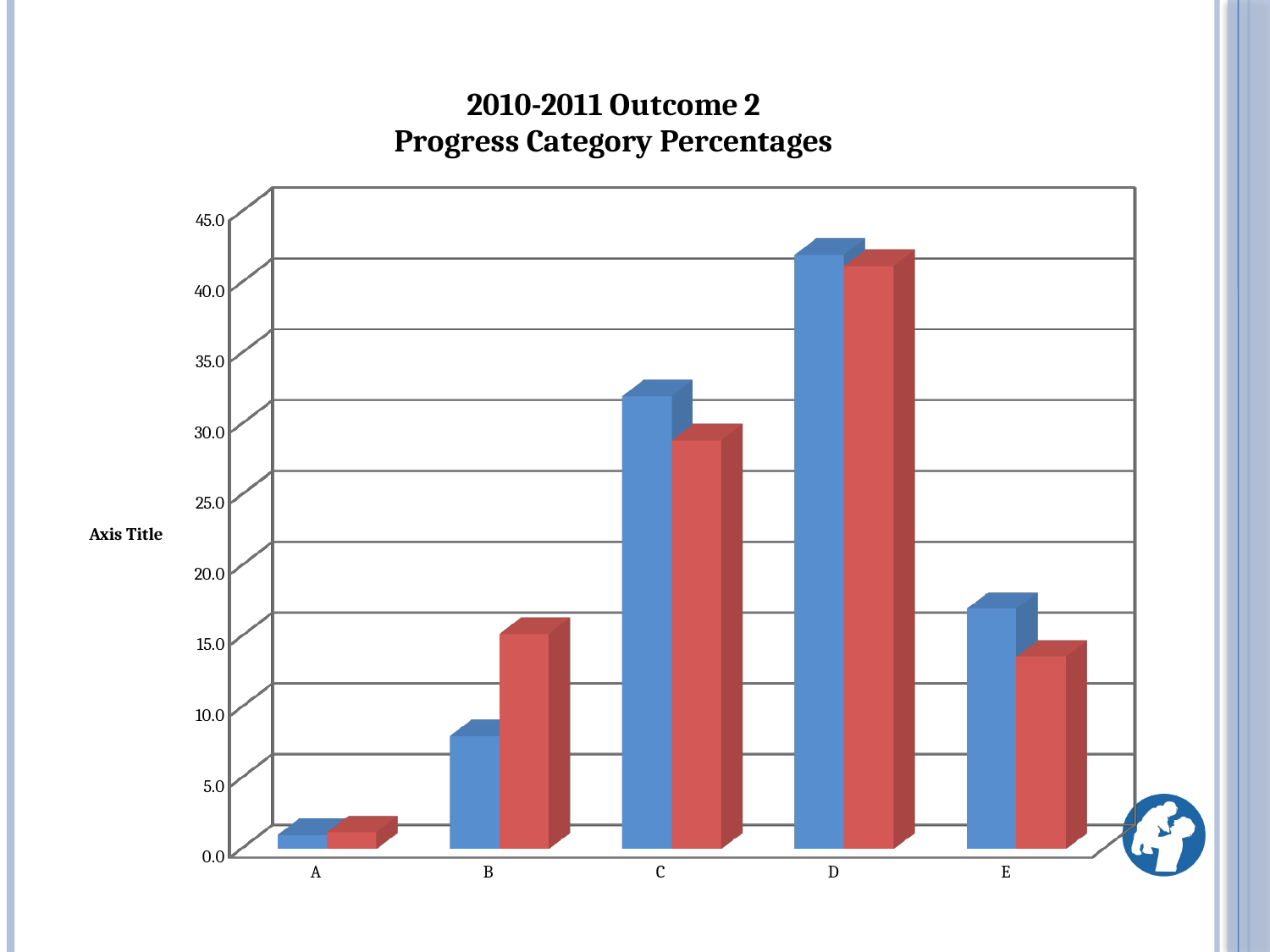
How many categories are shown on the x axis? 5 Is the value of the blue bar for A greater or less than 5.0? less Which category has the tallest blue bar? D For category B, which bar is taller, the blue one or the red one? The red one Which category has the tallest red bar? D What is the title of the chart? 2010-2011 Outcome 2 Progress Category Percentages Which category has the shortest blue bar? A What kind of chart is shown on the slide? Bar chart Is the value of the red bar for B greater or less than 10.0? greater Is the value of the blue bar for C greater or less than 30.0? greater For category C, which bar is taller, the blue one or the red one? The blue one